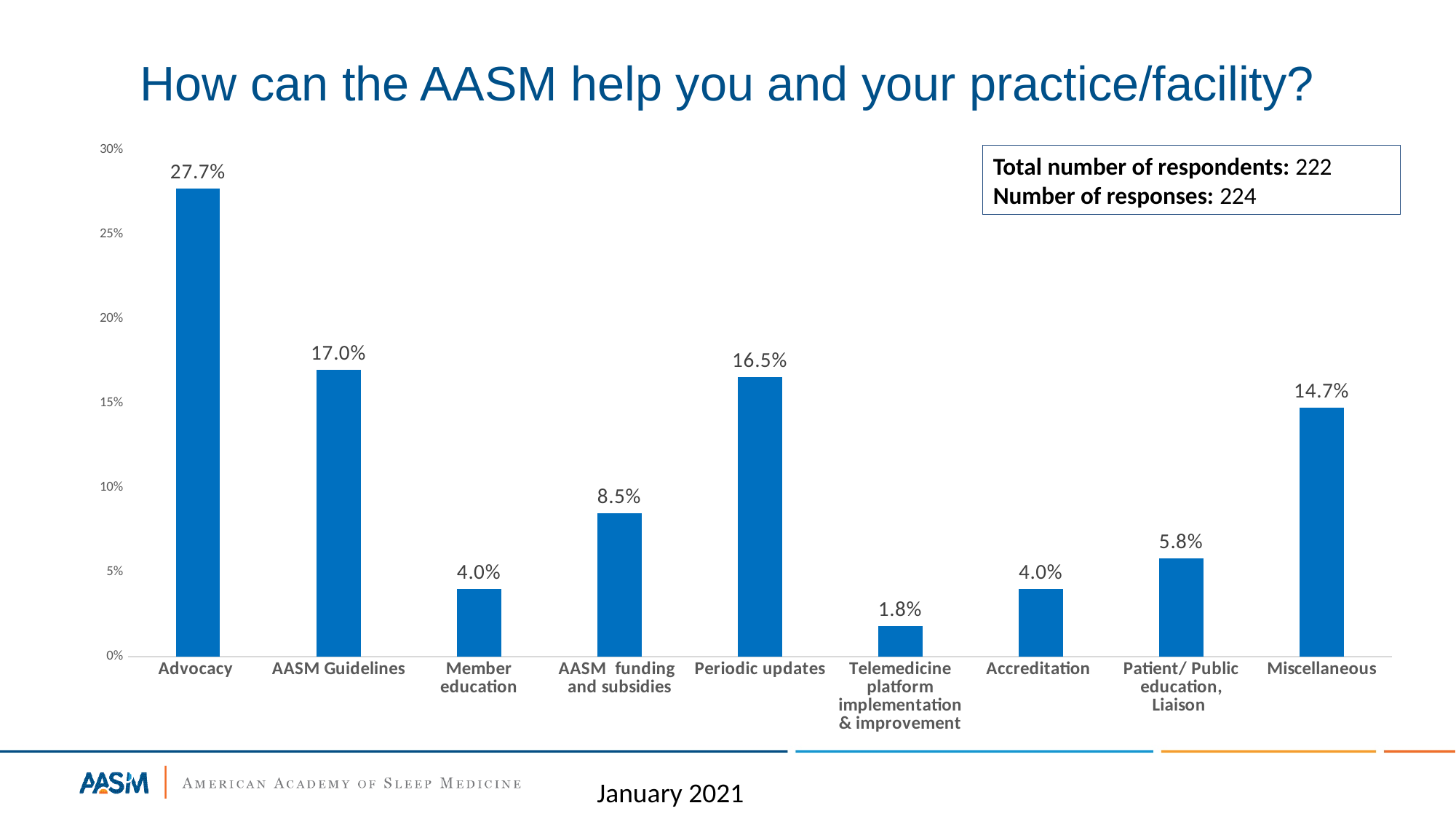
Is the value for Miscellaneous greater or less than 10%? greater Which category has the highest value? Advocacy What is the value for Advocacy? 27.7% What kind of chart is shown on the slide? bar chart How many categories are shown on the chart? 9 What is the value for Telemedicine platform implementation & improvement? 1.8% What is the difference between the values for Advocacy and AASM Guidelines? 10.7% Which is larger, the value for AASM funding and subsidies or the value for Patient/ Public education, Liaison? AASM funding and subsidies What is the value for Periodic updates? 16.5% Which category has the lowest value? Telemedicine platform implementation & improvement What is the value for Miscellaneous? 14.7% What is the title of the chart? How can the AASM help you and your practice/facility?